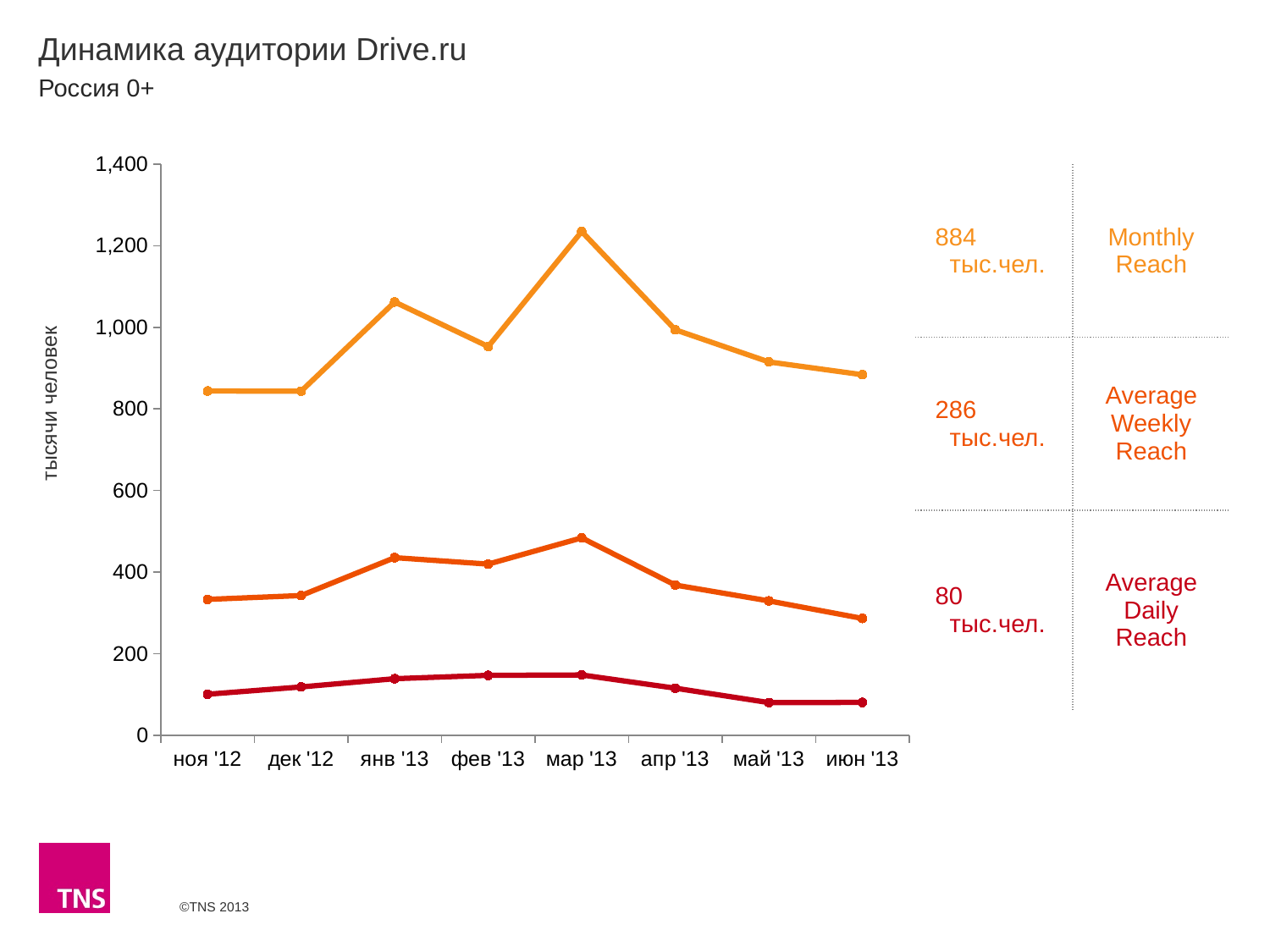
What is the Average Weekly Reach value for июн '13? 286 тыс.чел. In which month is Average Weekly Reach highest? мар '13 How many months are plotted along the x axis? 8 What is the Average Daily Reach value for июн '13? 80 тыс.чел. Is the Monthly Reach value for ноя '12 greater or less than 1,000? less Is the Monthly Reach value for мар '13 greater or less than 1,200? greater What is the Monthly Reach value for июн '13? 884 тыс.чел. What is the difference between Monthly Reach and Average Weekly Reach in июн '13? 598 тыс.чел. What kind of chart is shown on the slide? line chart Does Monthly Reach rise or fall from мар '13 to июн '13? fall How many lines (series) are plotted on the chart? 3 In which month is Monthly Reach highest? мар '13